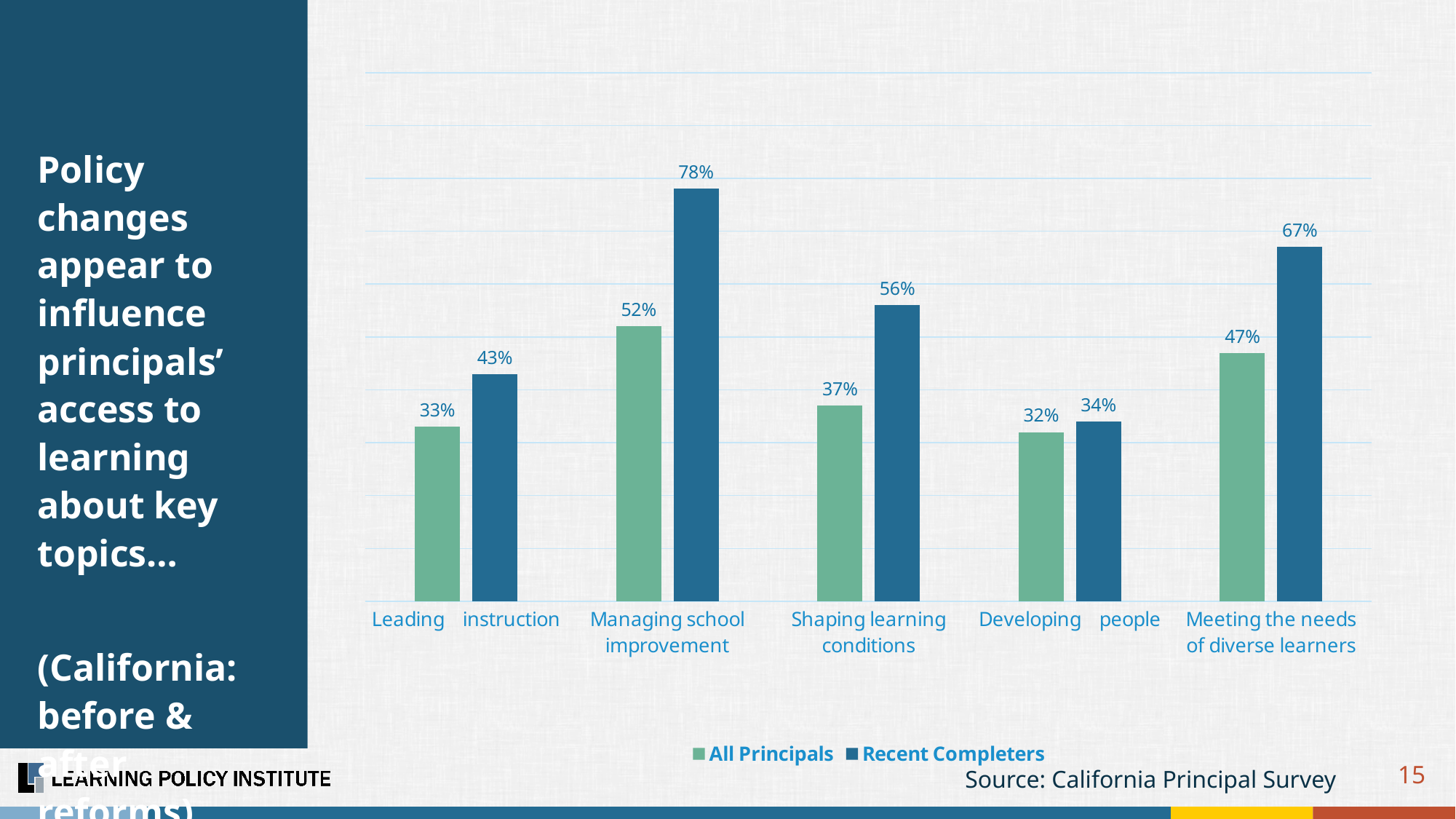
What is the value for All Principals for Developing people? 32% Which is larger for Meeting the needs of diverse learners: All Principals or Recent Completers? Recent Completers What is the value for All Principals for Leading instruction? 33% What kind of chart is shown on the slide? Bar chart What is the difference between Recent Completers and All Principals for Managing school improvement? 26% What is the difference between Recent Completers and All Principals for Shaping learning conditions? 19% Which category has the lowest value for All Principals? Developing people What is the value for Recent Completers for Meeting the needs of diverse learners? 67% How many categories are shown on the x axis? 5 Which category has the highest value for Recent Completers? Managing school improvement What is the value for Recent Completers for Managing school improvement? 78% How many series does the legend list? 2